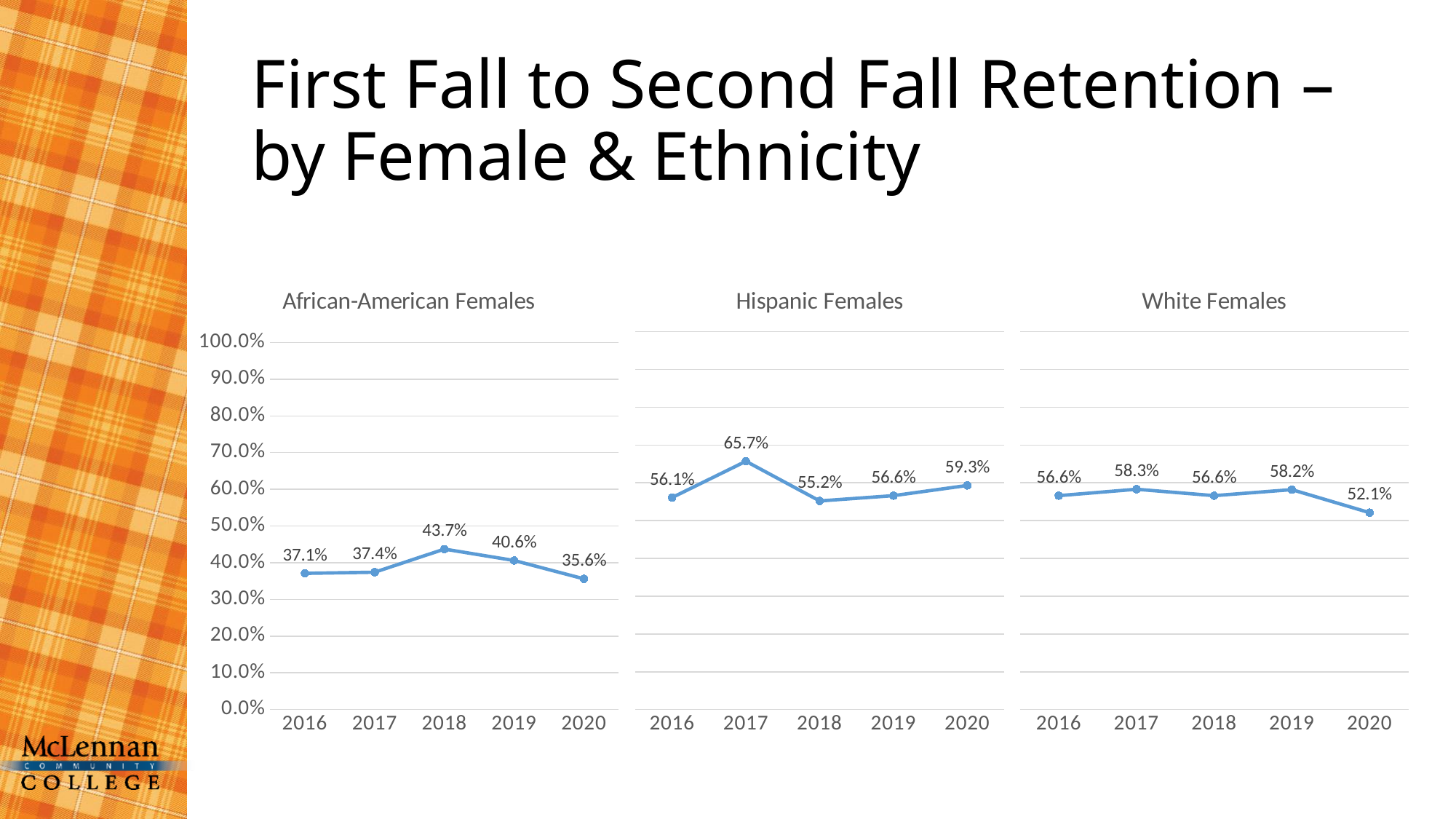
In the White Females chart, which year has the lowest retention value? 2020 What kind of chart is the African-American Females chart? line chart In the Hispanic Females chart, what is the retention value for 2017? 65.7% In the White Females chart, is the value for 2019 greater or less than 50.0%? greater In the White Females chart, what is the retention value for 2020? 52.1% In the White Females chart, does the value rise or fall from 2019 to 2020? fall How many years are plotted on the x axis of the Hispanic Females chart? 5 In the African-American Females chart, what is the retention value for 2018? 43.7% In the Hispanic Females chart, which is larger, the value for 2017 or the value for 2018? 2017 In the Hispanic Females chart, which year has the highest retention value? 2017 In the African-American Females chart, what is the difference between the 2018 and 2020 values? 8.1% In the African-American Females chart, which year has the lowest retention value? 2020